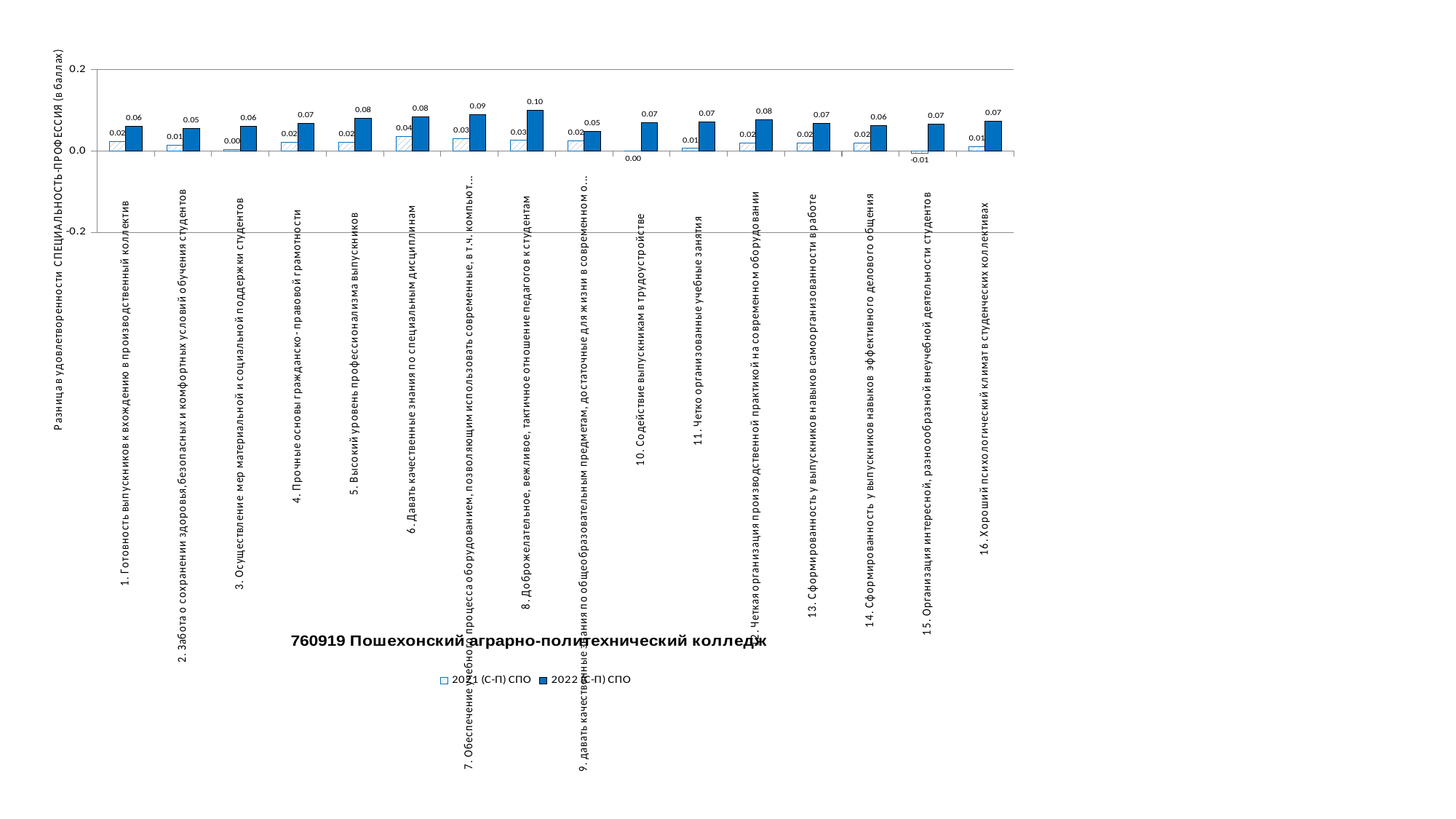
What is the 2022 (С-П) СПО value for category 8, 'Доброжелательное, вежливое, тактичное отношение педагогов к студентам'? 0.10 What is the 2021 (С-П) СПО value for category 15, 'Организация интересной, разнообразной внеучебной деятельности студентов'? -0.01 How many series does the legend list? 2 What type of chart is shown on the slide? Bar chart How many categories are plotted on the x axis? 16 What is the 2022 (С-П) СПО value for category 3, 'Осуществление мер материальной и социальной поддержки студентов'? 0.06 Which category has the lowest 2021 (С-П) СПО value? 15. Организация интересной, разнообразной внеучебной деятельности студентов What is the title of the chart? 760919 Пошехонский аграрно-политехнический колледж For category 7, 'Обеспечение учебного процесса оборудованием...', which series has the larger value, 2021 (С-П) СПО or 2022 (С-П) СПО? 2022 (С-П) СПО What is the difference between the 2022 and 2021 values for category 10, 'Содействие выпускникам в трудоустройстве'? 0.07 Which category has the highest 2022 (С-П) СПО value? 8. Доброжелательное, вежливое, тактичное отношение педагогов к студентам What is the 2021 (С-П) СПО value for category 6, 'Давать качественные знания по специальным дисциплинам'? 0.04